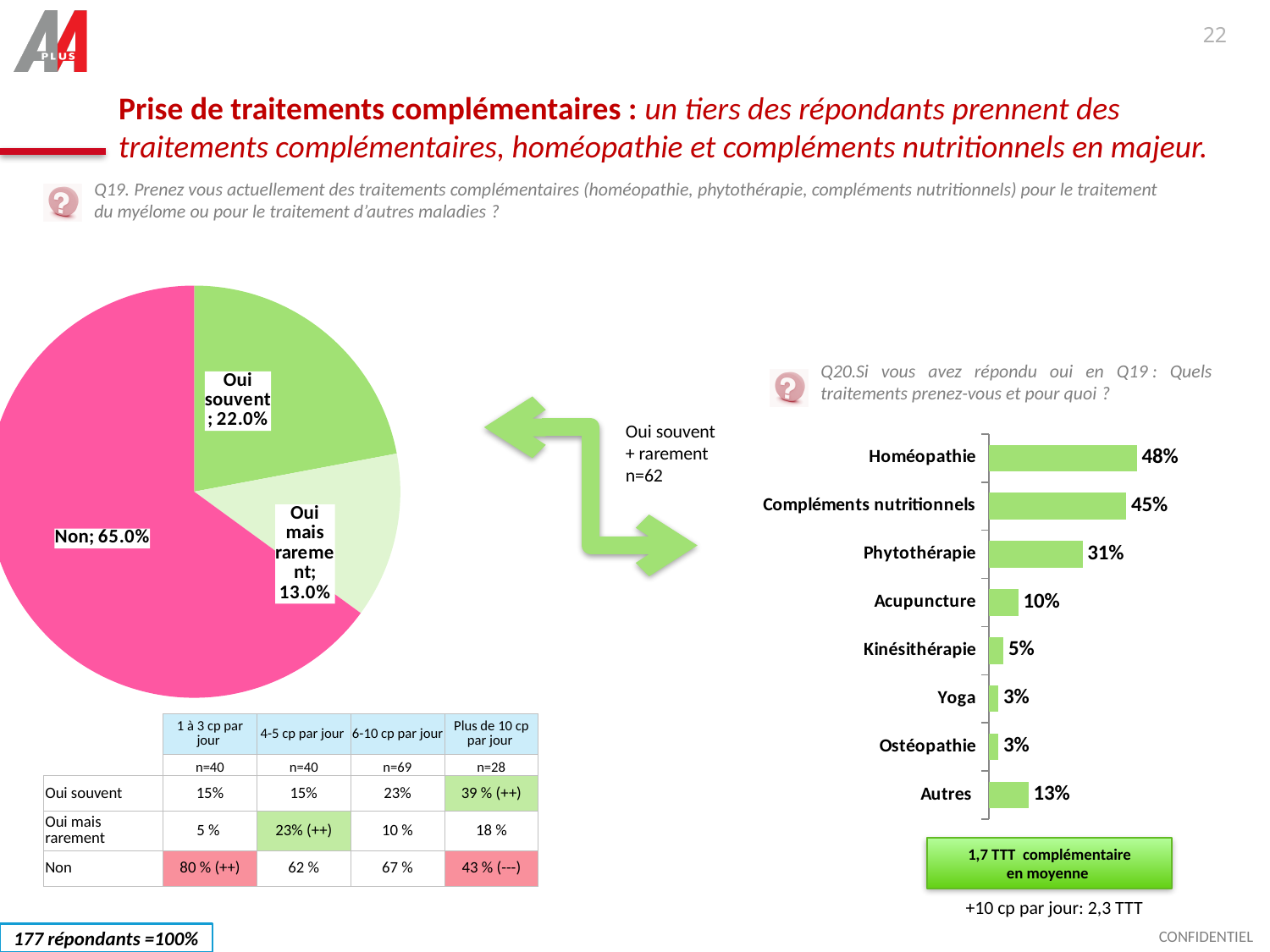
In the pie chart on the left, which category has the largest slice? Non In the bar chart on the right, how many categories are shown? 8 What type of chart is the chart on the left of the slide? Pie chart In the bar chart on the right, what is the value for Phytothérapie? 31% In the pie chart on the left, what share of respondents answered "Oui souvent"? 22.0% In the bar chart on the right, which is larger: Acupuncture or Autres? Autres In the bar chart on the right, which category has the lowest value? Yoga and Ostéopathie (3%) In the pie chart on the left, what share of respondents answered "Non"? 65.0% In the pie chart on the left, how many slices are there? 3 In the bar chart on the right, what is the value for Homéopathie? 48% In the bar chart on the right, what is the difference between Homéopathie and Compléments nutritionnels? 3 percentage points In the pie chart on the left, what share of respondents answered "Oui mais rarement"? 13.0%